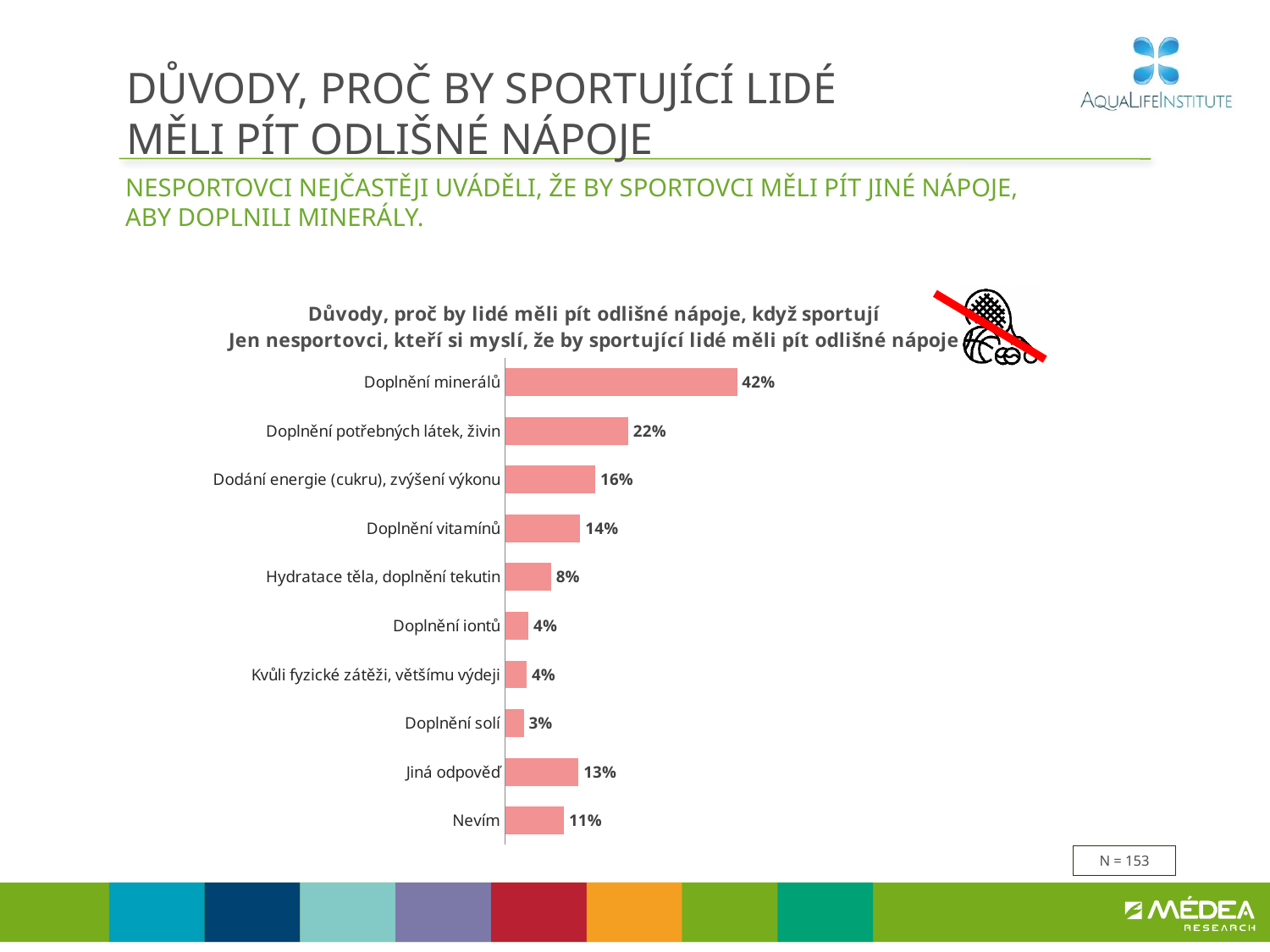
What sample size (N) is shown on the slide? N = 153 Which is larger, Nevím or Jiná odpověď? Jiná odpověď What is the difference between Dodání energie (cukru), zvýšení výkonu and Doplnění vitamínů? 2% What is the value for Hydratace těla, doplnění tekutin? 8% Which category has the highest value? Doplnění minerálů What kind of chart is shown on the slide? Bar chart Which is larger, Doplnění vitamínů or Hydratace těla, doplnění tekutin? Doplnění vitamínů How many categories are shown in the chart? 10 Which category has the lowest value? Doplnění solí What is the value for Doplnění minerálů? 42% What is the value for Jiná odpověď? 13% What is the difference between Doplnění minerálů and Doplnění potřebných látek, živin? 20%